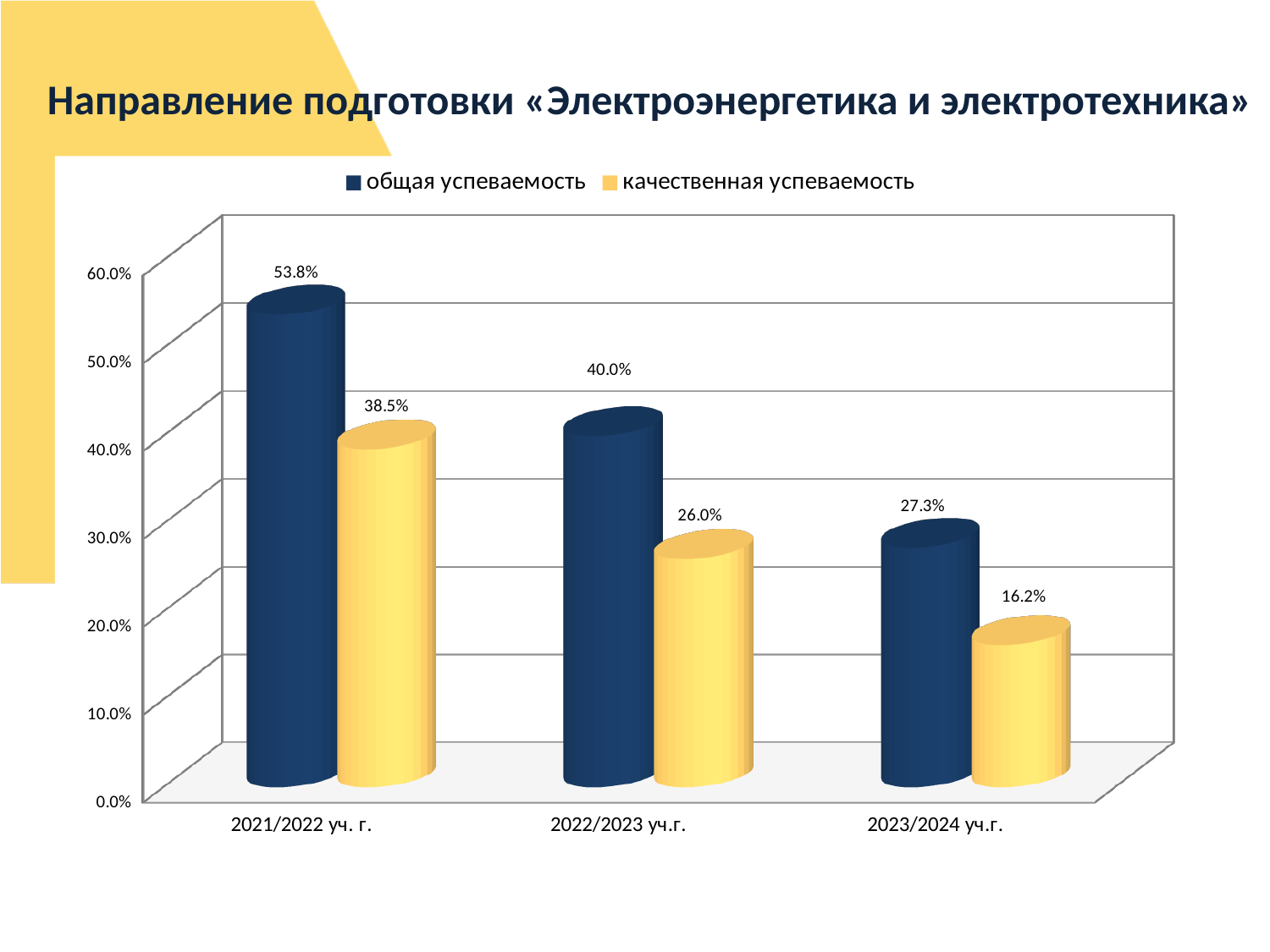
Does общая успеваемость rise or fall from 2021/2022 уч. г. to 2023/2024 уч.г.? Fall How many series does the legend list? 2 Which academic year has the highest общая успеваемость? 2021/2022 уч. г. What kind of chart is shown on the slide? Bar chart What is the value of общая успеваемость for 2022/2023 уч.г.? 40.0% What is the difference between общая успеваемость and качественная успеваемость in 2021/2022 уч. г.? 15.3% What is the value of качественная успеваемость for 2023/2024 уч.г.? 16.2% Which academic year has the lowest качественная успеваемость? 2023/2024 уч.г. What is the value of качественная успеваемость for 2022/2023 уч.г.? 26.0% What is the value of общая успеваемость for 2021/2022 уч. г.? 53.8% How many academic years are shown on the x axis? 3 Which is larger: общая успеваемость in 2023/2024 уч.г. or качественная успеваемость in 2022/2023 уч.г.? общая успеваемость in 2023/2024 уч.г.